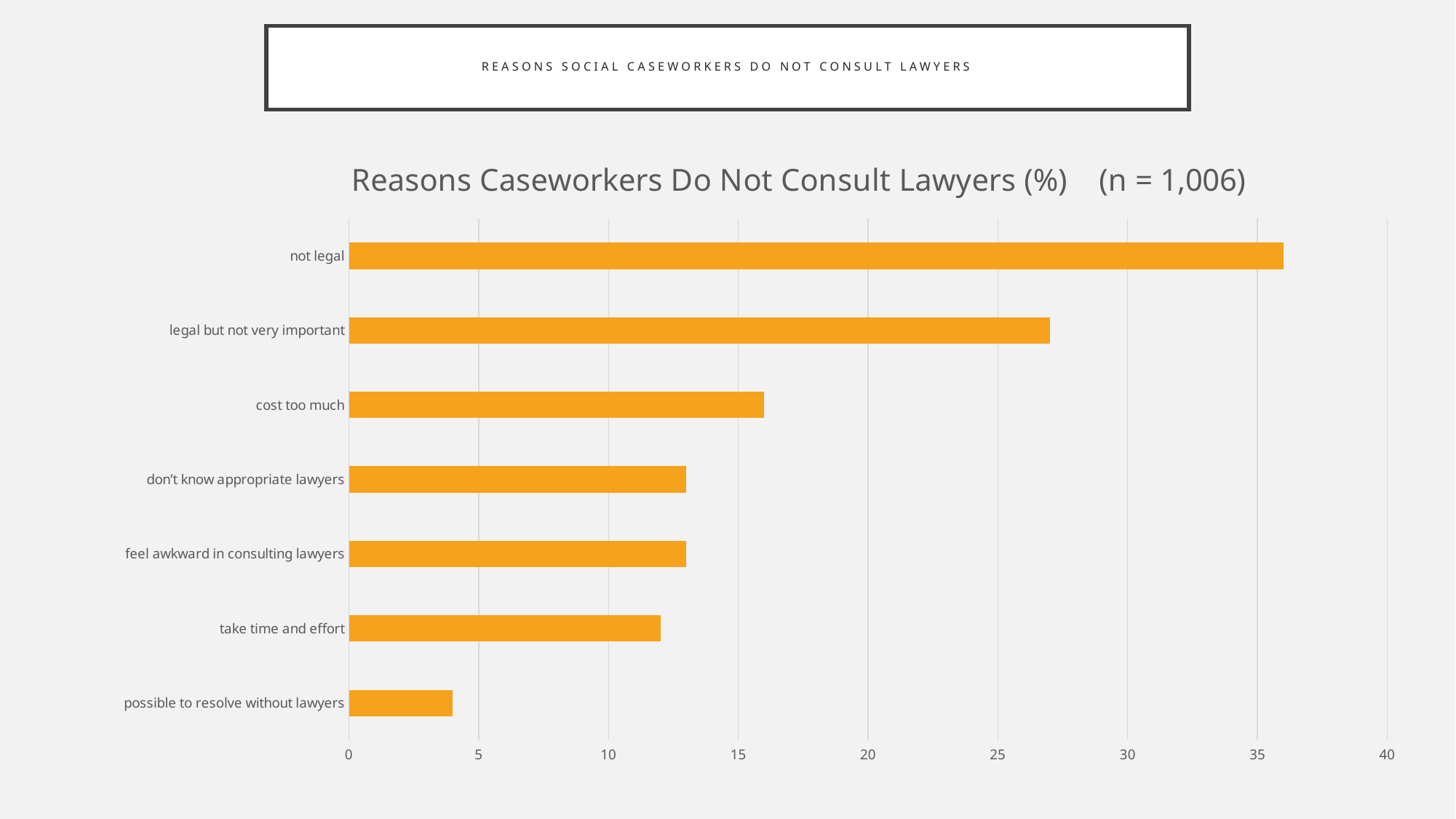
Is the value for "cost too much" greater or less than 20? less Which has a larger value: "not legal" or "legal but not very important"? not legal Which reason has the highest value in the chart? not legal What kind of chart is shown on the slide? bar chart What sample size (n) is stated in the chart title? n = 1,006 What colour are the bars in the chart? orange Is the value for "not legal" greater or less than 30? greater How many reasons (categories) are plotted in the chart? 7 Which has a larger value: "cost too much" or "take time and effort"? cost too much Which reason has the lowest value in the chart? possible to resolve without lawyers Is the value for "legal but not very important" greater or less than 25? greater